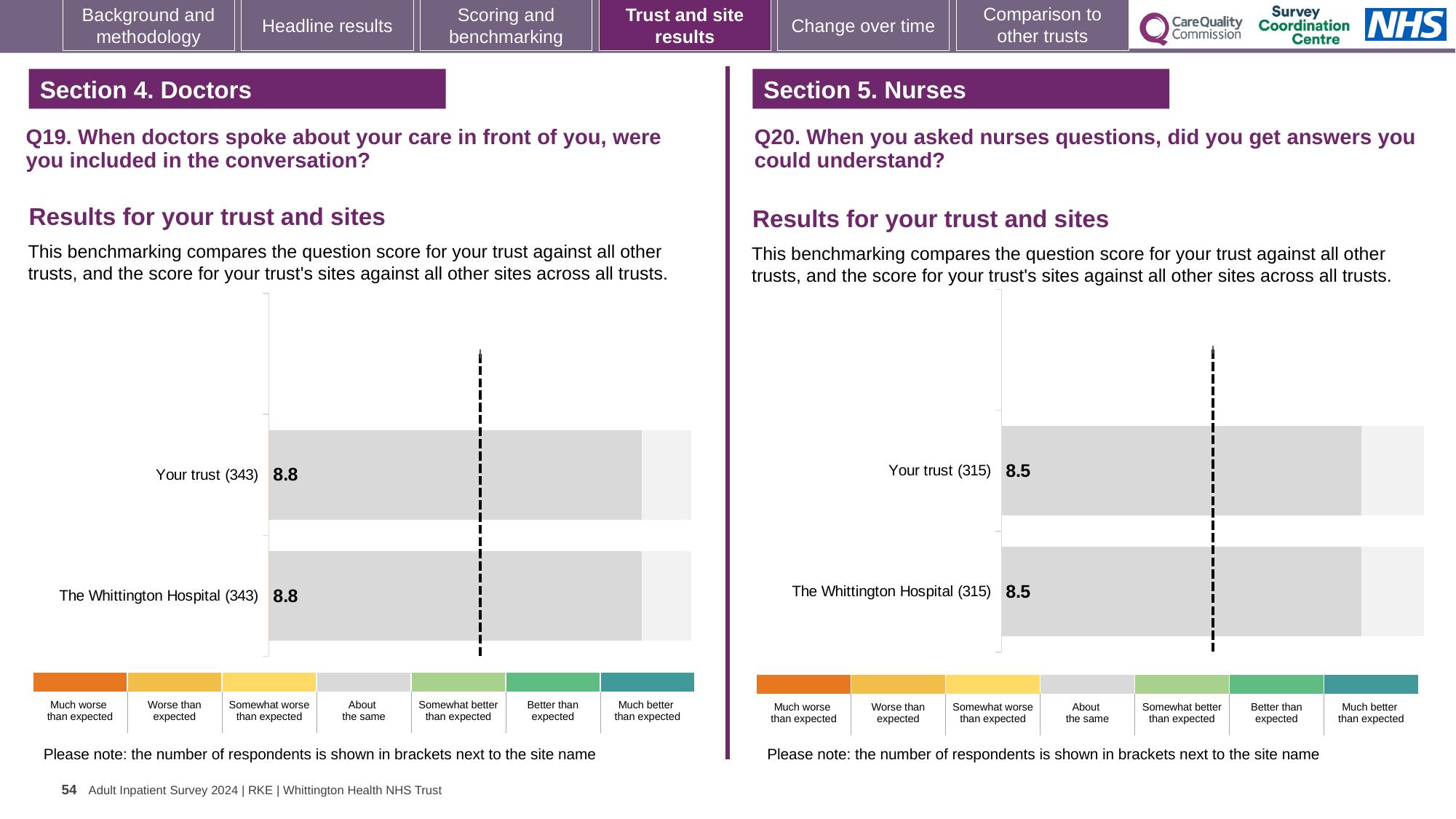
On the Q19 chart (Section 4. Doctors), what is the score for The Whittington Hospital? 8.8 On the Q20 chart (Section 5. Nurses), how many respondents are shown in brackets for The Whittington Hospital? 315 What kind of chart is used on the Q19 chart (Section 4. Doctors)? Bar chart Is the score for Your trust on the Q19 chart (Section 4. Doctors) larger than the score for Your trust on the Q20 chart (Section 5. Nurses)? Yes On the Q20 chart (Section 5. Nurses), how many categories does the colour key below the chart list? 7 On the Q19 chart (Section 4. Doctors), what is the score for Your trust? 8.8 On the Q20 chart (Section 5. Nurses), what is the score for The Whittington Hospital? 8.5 On the Q19 chart (Section 4. Doctors), what colour is the 'Much worse than expected' category in the key below the chart? Orange On the Q19 chart (Section 4. Doctors), how many respondents are shown in brackets for Your trust? 343 On the Q19 chart (Section 4. Doctors), what is the difference between the score for Your trust and the score for The Whittington Hospital? 0.0 On the Q20 chart (Section 5. Nurses), what is the score for Your trust? 8.5 On the Q20 chart (Section 5. Nurses), how many bars are plotted? 2